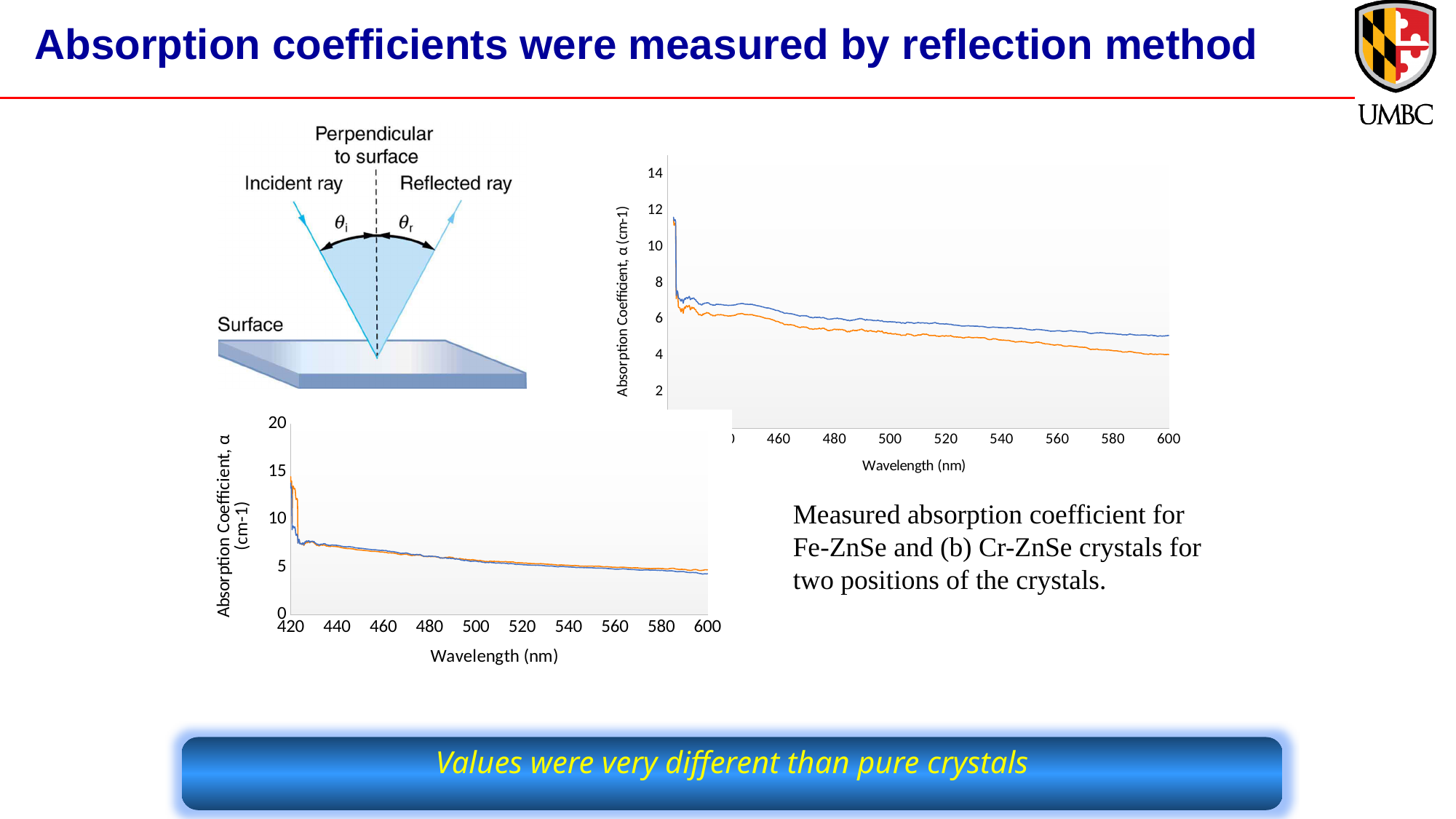
What type of chart is the upper-right chart on the slide? line chart In the upper-right chart, is the value of the orange line at 500 nm greater or less than 8? less In the upper-right chart, how many lines are plotted? 2 In the upper-right chart, what is the x-axis label? Wavelength (nm) In the lower-left chart, is the value of the lines at 600 nm greater or less than 10? less In the upper-right chart, at 600 nm, which line has the larger absorption coefficient, the blue line or the orange line? blue line In the upper-right chart, do the absorption coefficient values rise or fall as wavelength increases from 460 nm to 600 nm? fall In the lower-left chart, do the absorption coefficient values rise or fall as wavelength increases from 440 nm to 600 nm? fall In the lower-left chart, what is the y-axis label? Absorption Coefficient, α (cm-1) In the upper-right chart, is the value of the blue line at 600 nm greater or less than 4? greater In the lower-left chart, how many lines are plotted? 2 What type of chart is the lower-left chart on the slide? line chart